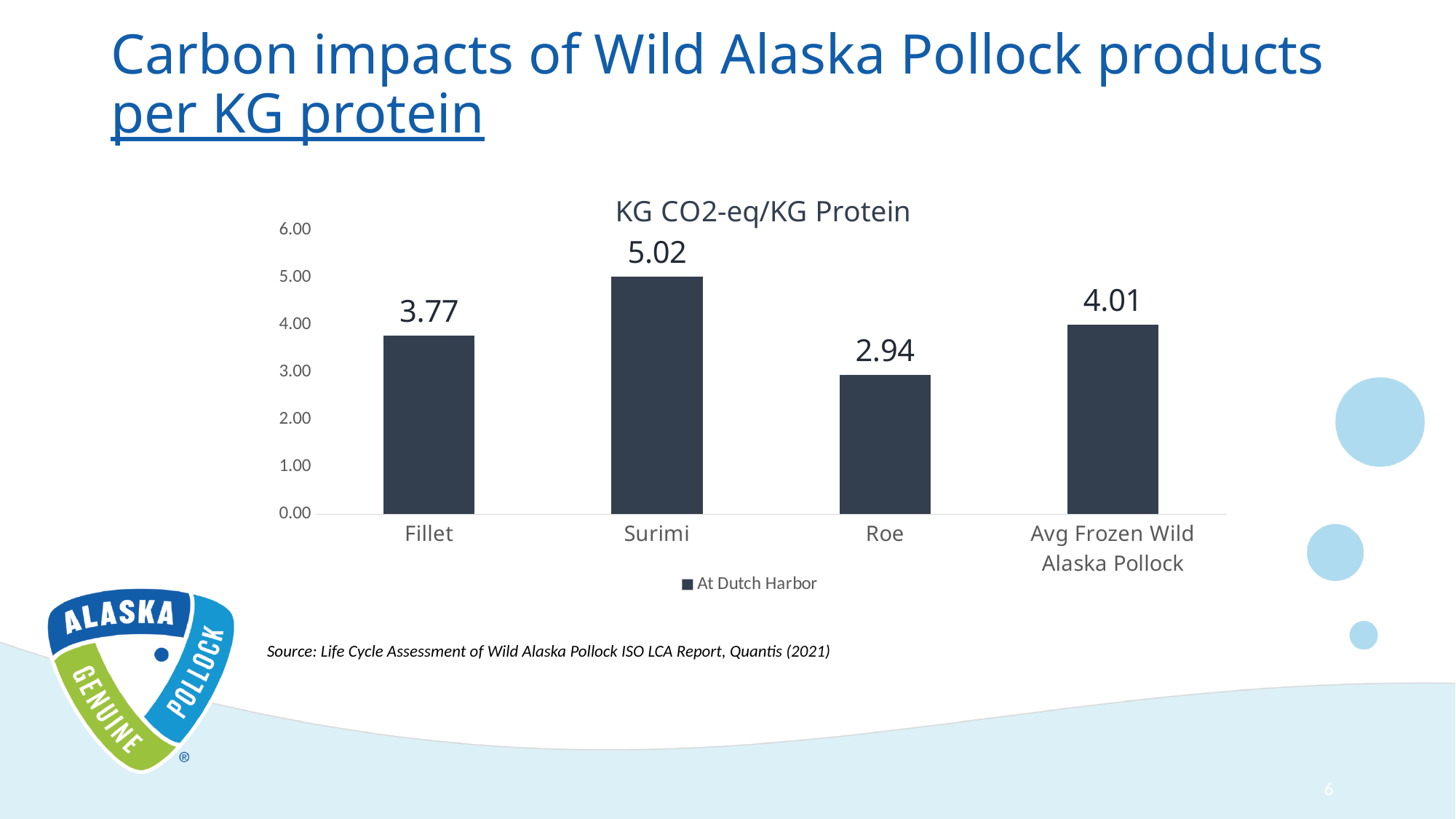
Which is larger, the value for Fillet or the value for Avg Frozen Wild Alaska Pollock? Avg Frozen Wild Alaska Pollock What is the title of the chart? KG CO2-eq/KG Protein What is the value for Avg Frozen Wild Alaska Pollock? 4.01 What is the value for Surimi? 5.02 What kind of chart is shown on the slide? Bar chart Is the value for Surimi greater or less than 4.00? greater Which category has the highest value? Surimi What is the value for Fillet? 3.77 What is the difference between the values for Surimi and Roe? 2.08 How many categories are shown on the x axis? 4 What is the value for Roe? 2.94 Which category has the lowest value? Roe